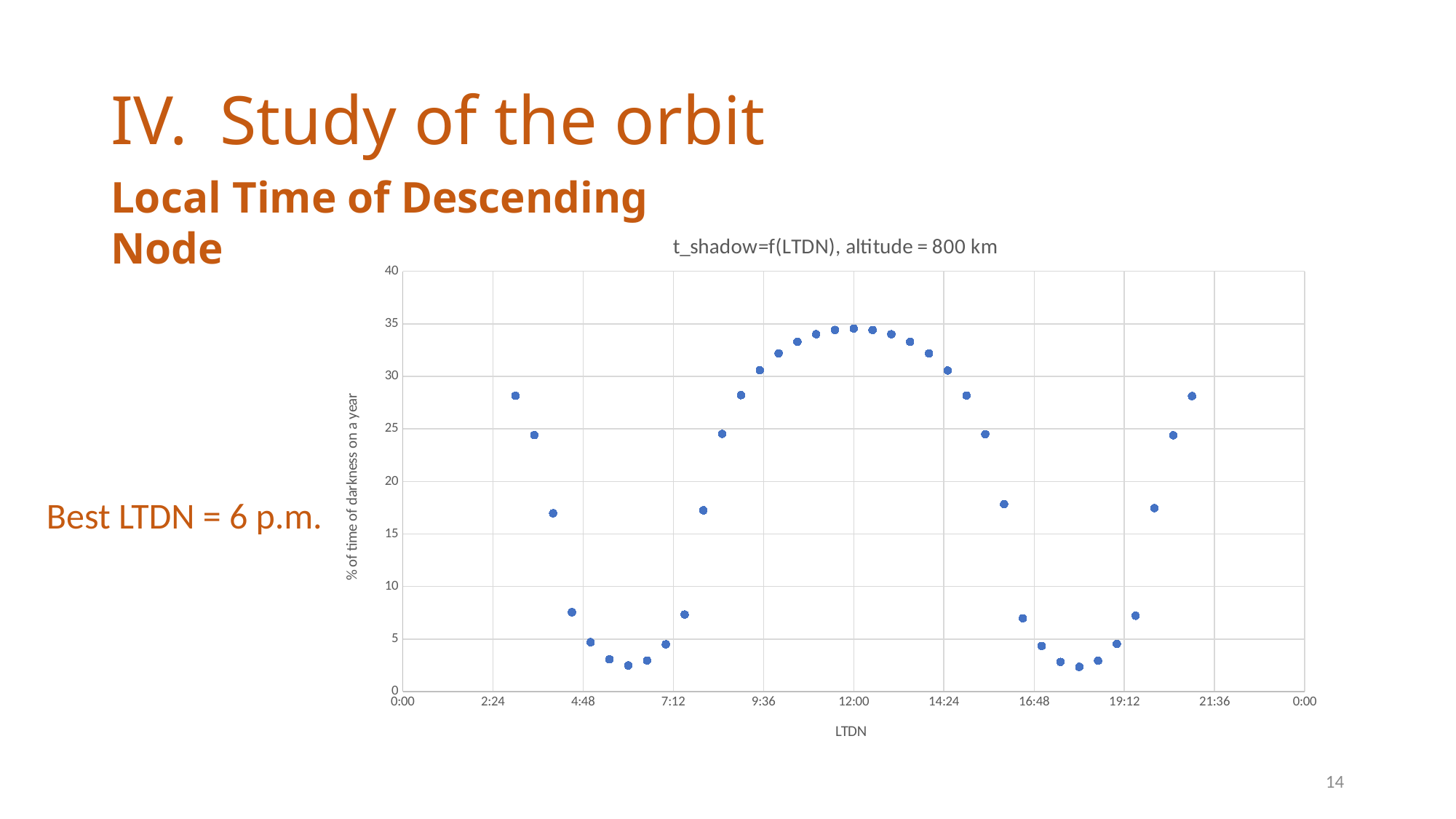
Do the plotted values rise or fall between 12:00 and 16:48 on the x axis? fall Is the highest plotted value greater or less than 30? greater What kind of chart is shown on the slide? scatter chart Is the value plotted at 12:00 greater or less than 25? greater At which x-axis tick do the plotted values reach their highest point? 12:00 What is the maximum value shown on the y axis of the chart? 40 What is the title of the chart? t_shadow=f(LTDN), altitude = 800 km Is the lowest plotted value greater or less than 5? less What is the label of the y axis of the chart? % of time of darkness on a year Which is larger, the value plotted at 12:00 or the value plotted at 9:36? 12:00 Do the plotted values rise or fall between 7:12 and 12:00 on the x axis? rise